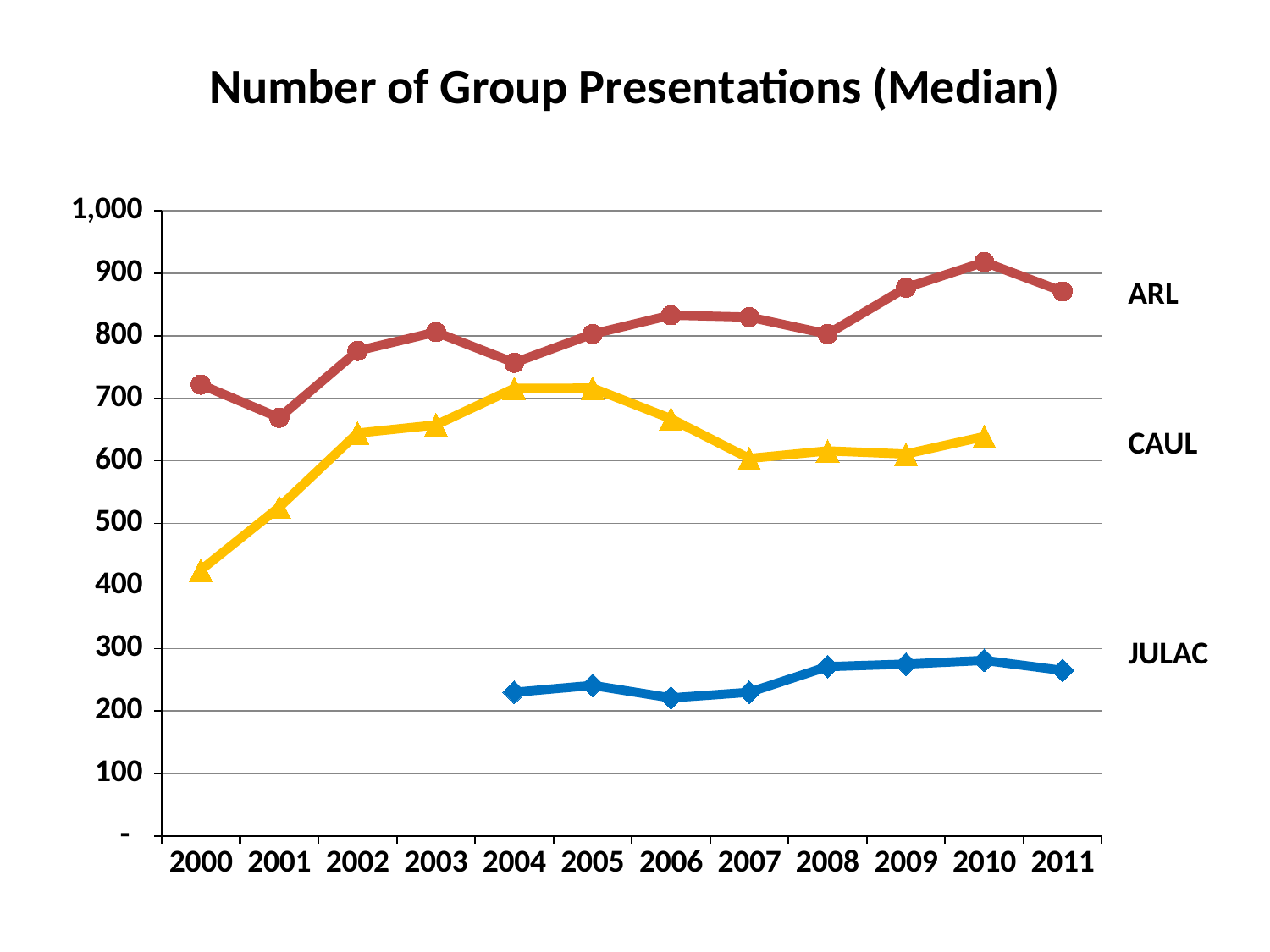
Is the value for JULAC in 2004 greater or less than 300? less Does the CAUL series rise or fall from 2000 to 2004? rise In which year does the ARL series have its lowest value? 2001 In which year does the CAUL series have its lowest value? 2000 What kind of chart is shown on the slide? line chart Which series has the larger value in 2005, ARL or CAUL? ARL Is the value for ARL in 2010 greater or less than 900? greater In which year does the ARL series reach its highest value? 2010 How many series does the chart show? 3 Is the value for CAUL in 2000 greater or less than 400? greater What is the title of the chart? Number of Group Presentations (Median) How many years are shown on the x axis? 12